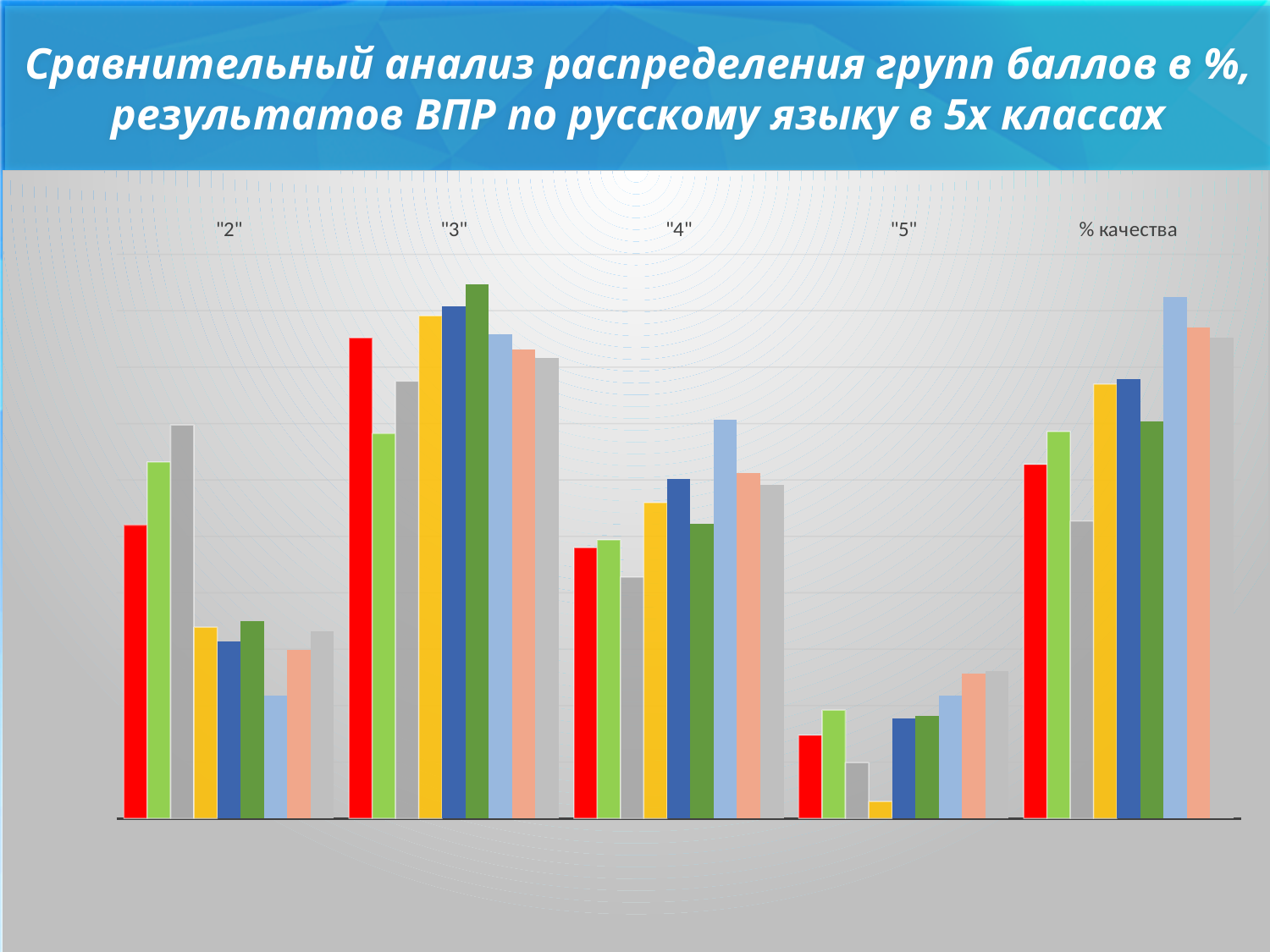
Which category has the lowest bars overall in the chart? "5" Which category contains the shortest bar in the chart? "5" How many categories are shown along the x axis of the chart? 5 What is the title of the slide containing the chart? Сравнительный анализ распределения групп баллов в %, результатов ВПР по русскому языку в 5х классах What kind of chart is shown on the slide? bar chart Is the yellow bar taller in category "2" or in category "% качества"? "% качества" Is the red bar taller in category "3" or in category "5"? "3" How many bars are plotted in each category group of the chart? 9 What is the label of the last category on the x axis? % качества Which category contains the tallest bar in the chart? "3"